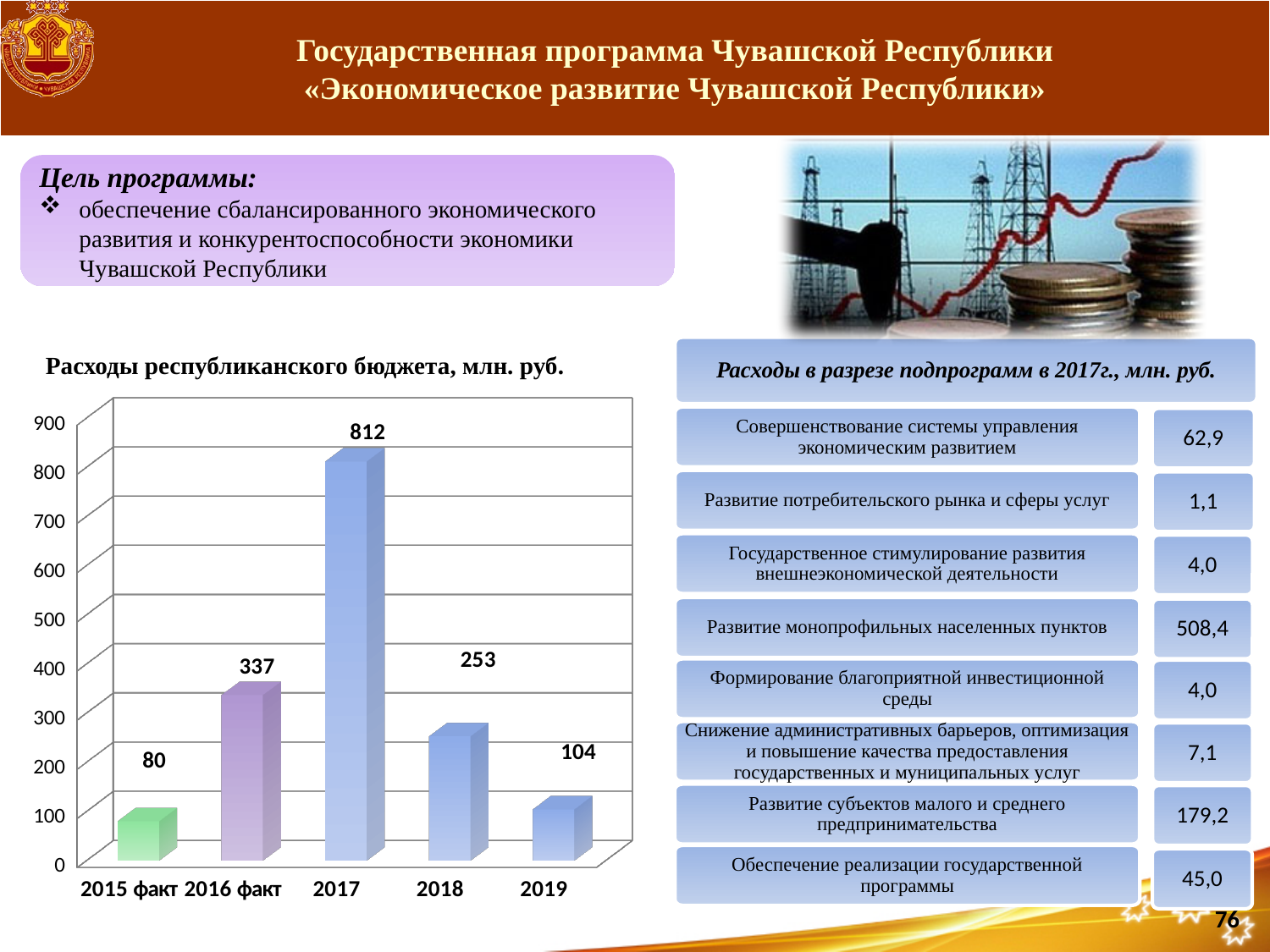
What is the value for 2019 in the chart? 104 Which category has the lowest value in the chart? 2015 факт What is the difference between the values for 2016 факт and 2015 факт? 257 What kind of chart is shown on the slide? bar chart How many categories are shown on the x axis of the chart? 5 What is the title of the chart on the slide? Расходы республиканского бюджета, млн. руб. Which year has the highest value in the chart? 2017 Is the value for 2018 greater or less than 300? less What is the value for 2017 in the chart "Расходы республиканского бюджета, млн. руб."? 812 What is the value for 2015 факт in the chart? 80 Which is larger, the value for 2016 факт or the value for 2018? 2016 факт What is the difference between the values for 2017 and 2018? 559